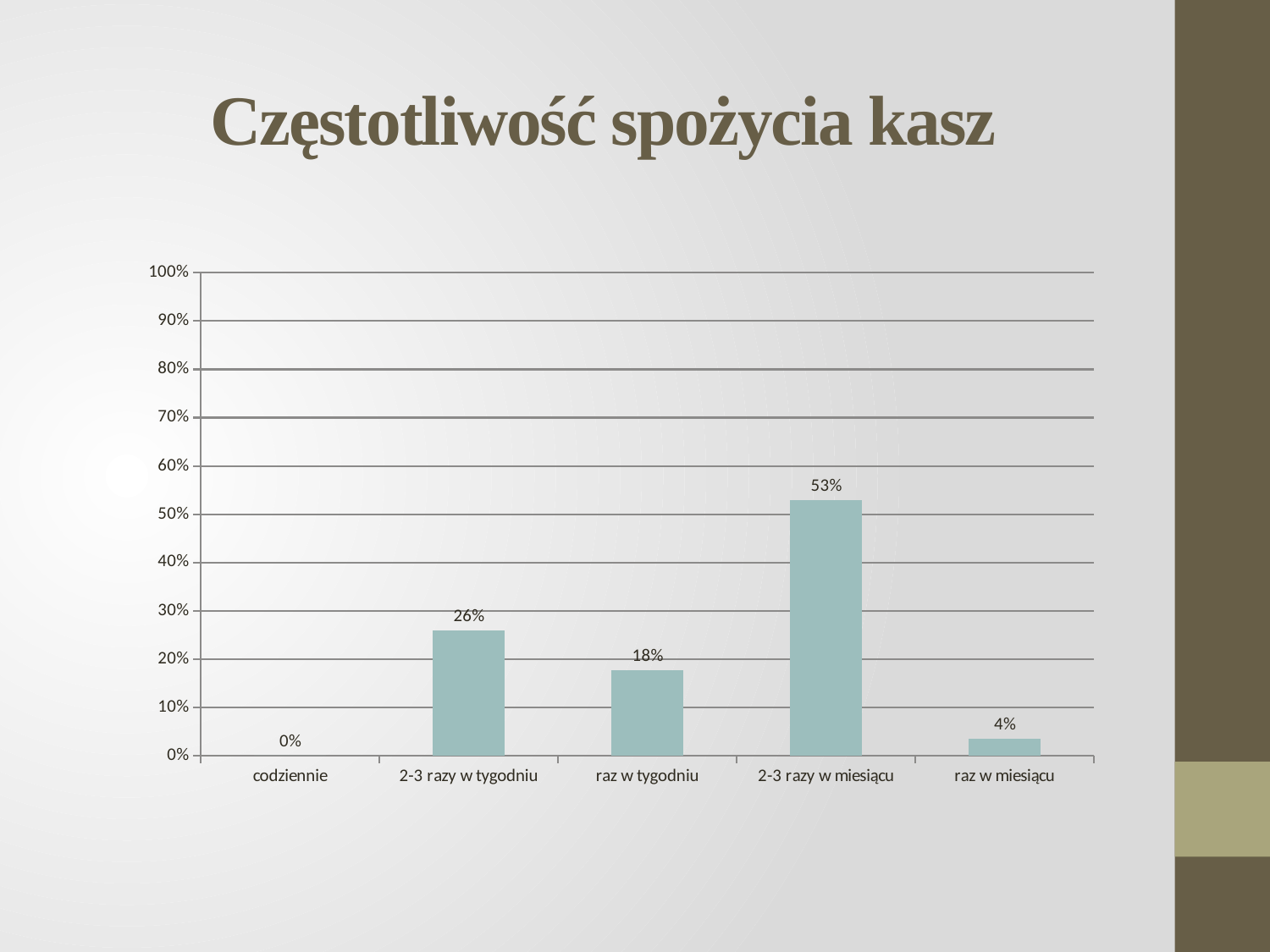
What is the difference between the values for "2-3 razy w miesiącu" and "2-3 razy w tygodniu"? 27% What is the title of the slide? Częstotliwość spożycia kasz What is the value for "raz w miesiącu"? 4% How many categories are shown on the x axis? 5 What is the value for "2-3 razy w miesiącu"? 53% Which category has the lowest value? codziennie What is the value for "codziennie"? 0% Which is larger, the value for "2-3 razy w tygodniu" or the value for "raz w tygodniu"? 2-3 razy w tygodniu What is the value for "raz w tygodniu"? 18% Is the value for "2-3 razy w miesiącu" greater or less than 50%? greater Which category has the highest value? 2-3 razy w miesiącu What kind of chart is shown on the slide? bar chart